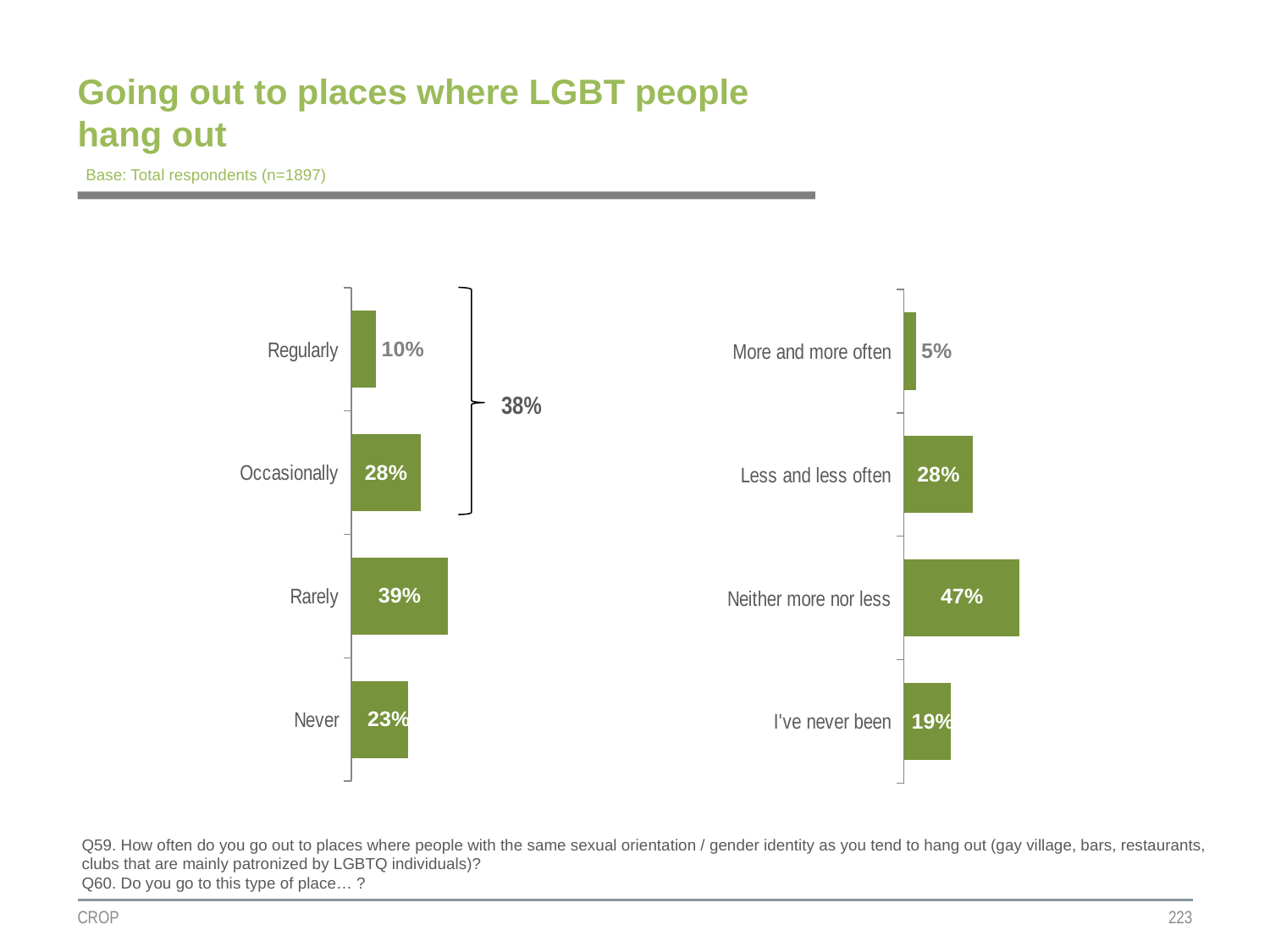
In the left chart, which is larger, Occasionally or Never? Occasionally In the left chart, which category has the highest value? Rarely In the left chart, what is the value for Regularly? 10% In the left chart, what is the difference between Rarely and Never? 16% In the right chart, what is the value for More and more often? 5% In the left chart, what is the value for Rarely? 39% In the left chart, what combined value does the bracket over Regularly and Occasionally show? 38% In the right chart, what is the difference between Neither more nor less and Less and less often? 19% What kind of chart is the left chart? Bar chart In the right chart, what is the value for Neither more nor less? 47% In the right chart, which category has the lowest value? More and more often How many categories does the right chart show? 4